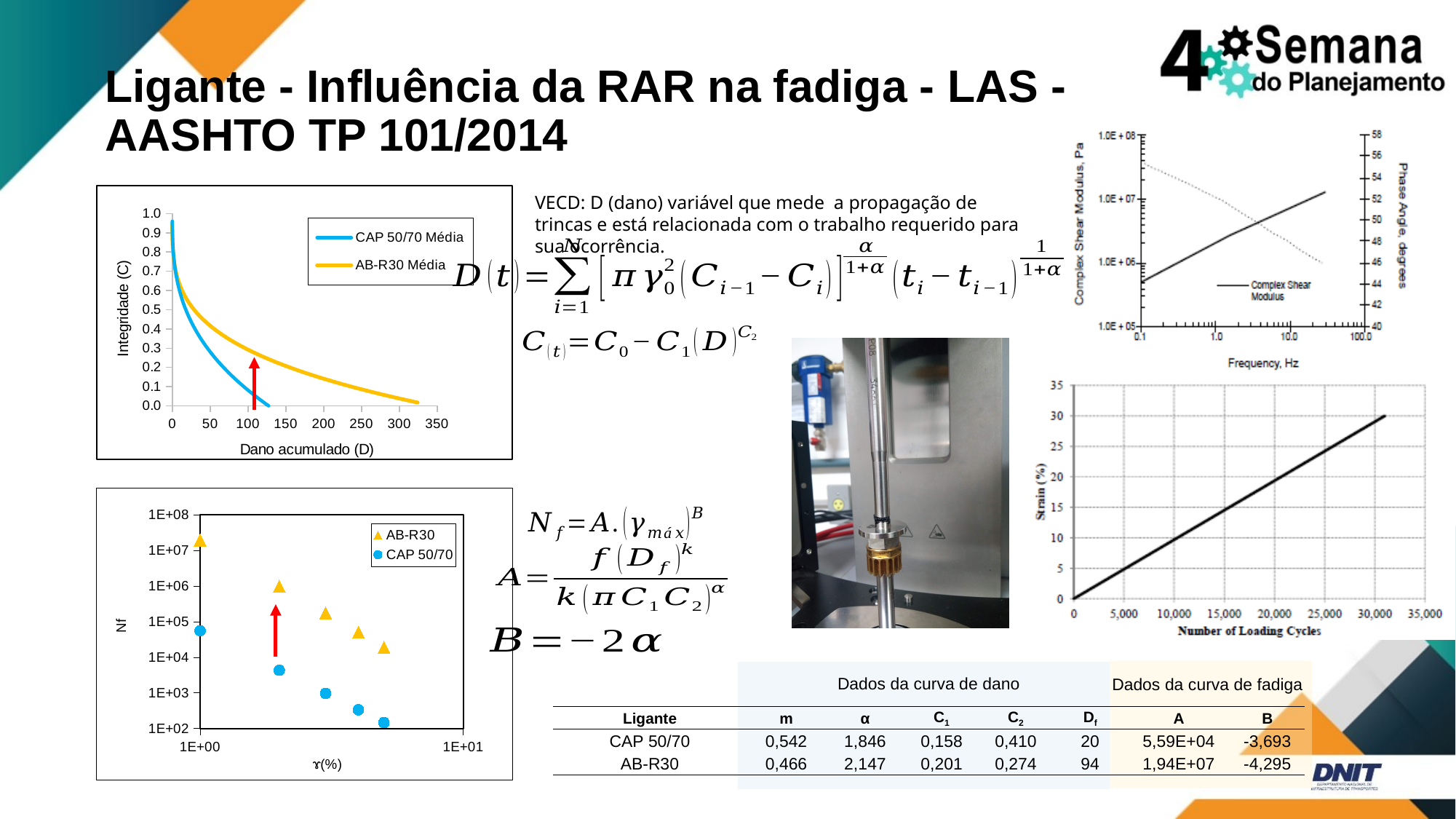
In the bottom-left chart (Nf vs γ(%)), do the Nf values rise or fall as γ(%) increases? fall In the top-left chart (Integridade (C) vs Dano acumulado (D)), do the values rise or fall as Dano acumulado increases? fall In the right-hand chart of Strain (%) vs Number of Loading Cycles, does strain rise or fall as the number of loading cycles increases? rise In the top-left chart (Integridade (C) vs Dano acumulado (D)), how many series does the legend list? 2 What kind of chart is the bottom-left chart (Nf vs γ(%))? scatter chart In the top-left chart (Integridade (C) vs Dano acumulado (D)), what are the two series named in the legend? CAP 50/70 Média and AB-R30 Média In the top-left chart (Integridade (C) vs Dano acumulado (D)), which series reaches a larger accumulated damage (D) before integrity drops to zero, CAP 50/70 Média or AB-R30 Média? AB-R30 Média In the bottom-left chart (Nf vs γ(%)), how many data points are plotted for the AB-R30 series? 5 In the bottom-left chart (Nf vs γ(%)), which series has the higher Nf values, AB-R30 or CAP 50/70? AB-R30 In the top-left chart (Integridade (C) vs Dano acumulado (D)), is the accumulated damage at which the CAP 50/70 Média curve reaches zero greater or less than 150? less In the top-left chart (Integridade (C) vs Dano acumulado (D)), is the accumulated damage at which the AB-R30 Média curve reaches zero greater or less than 300? greater